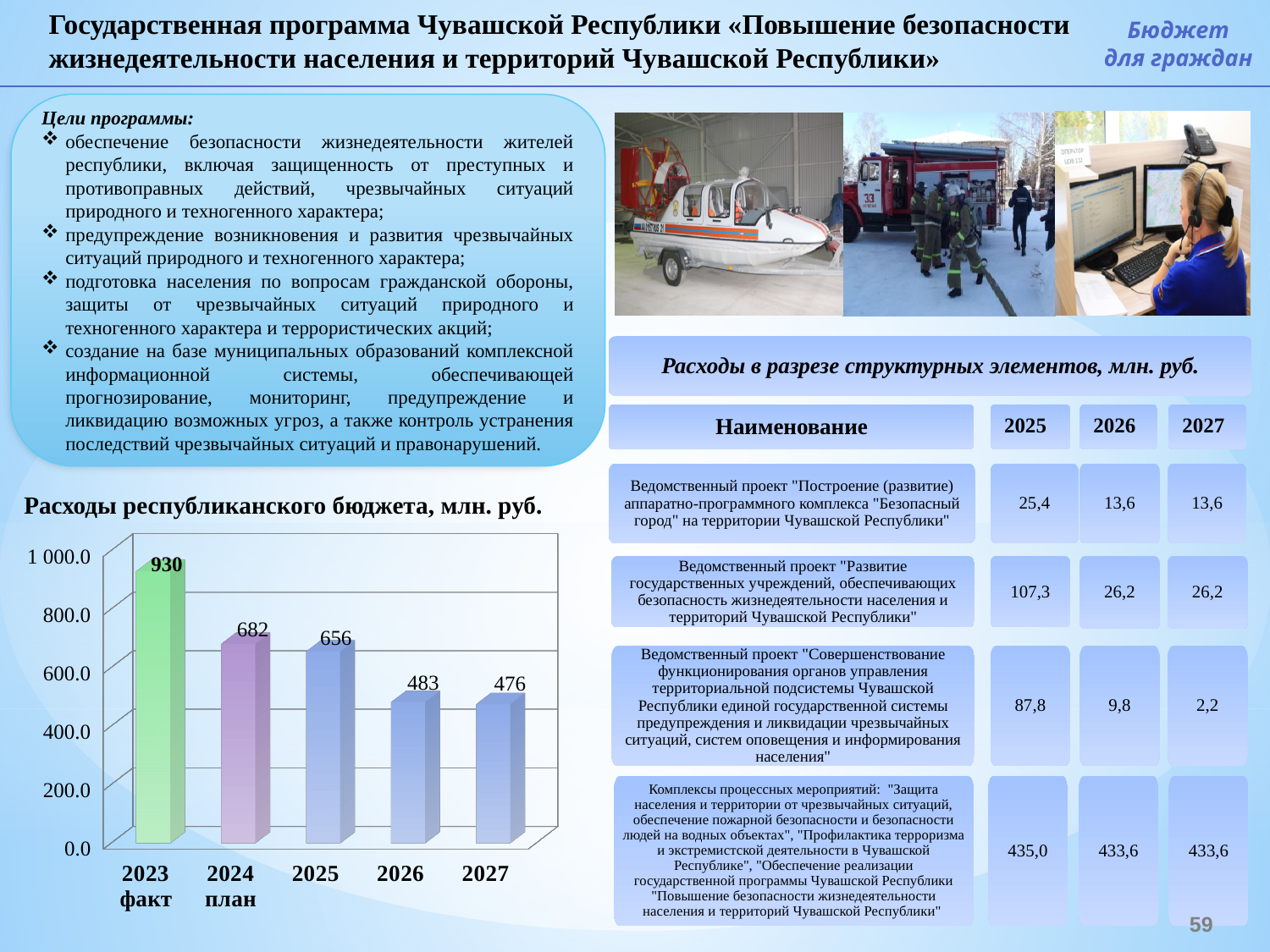
How many categories are shown in the chart 'Расходы республиканского бюджета, млн. руб.'? 5 Do the values in the chart 'Расходы республиканского бюджета, млн. руб.' rise or fall from 2023 факт to 2027? Fall What is the value for 2023 факт in the chart 'Расходы республиканского бюджета, млн. руб.'? 930 What is the value for 2027 in the chart 'Расходы республиканского бюджета, млн. руб.'? 476 What kind of chart is 'Расходы республиканского бюджета, млн. руб.'? Bar chart What is the value for 2026 in the chart 'Расходы республиканского бюджета, млн. руб.'? 483 What is the value for 2024 план in the chart 'Расходы республиканского бюджета, млн. руб.'? 682 Which category has the lowest value in the chart 'Расходы республиканского бюджета, млн. руб.'? 2027 Which category has the highest value in the chart 'Расходы республиканского бюджета, млн. руб.'? 2023 факт Which is larger in the chart 'Расходы республиканского бюджета, млн. руб.': the value for 2024 план or the value for 2025? 2024 план What is the difference between the values for 2025 and 2026 in the chart 'Расходы республиканского бюджета, млн. руб.'? 173 What is the difference between the values for 2023 факт and 2024 план in the chart 'Расходы республиканского бюджета, млн. руб.'? 248